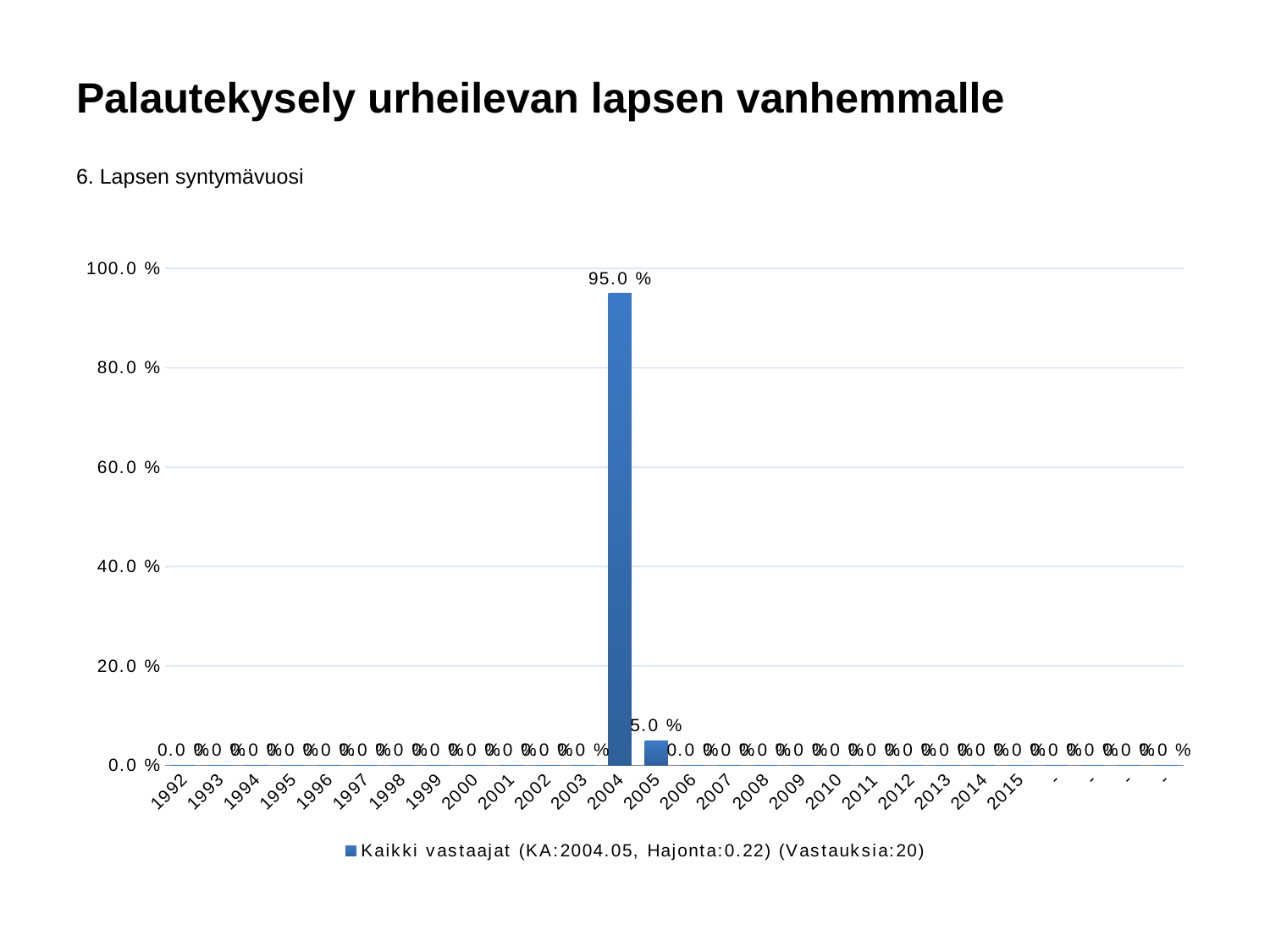
How many birth years have a value above 0.0 %? 2 What is the value for 2003? 0.0 % What is the legend entry of the chart? Kaikki vastaajat (KA:2004.05, Hajonta:0.22) (Vastauksia:20) Which birth year has the highest value? 2004 What is the difference between the values for 2004 and 2005? 90.0 % How many series does the legend list? 1 What is the value for 2004? 95.0 % What is the value for 2005? 5.0 % Is the value for 2004 greater or less than 80.0 %? greater Is the value for 2005 greater or less than 20.0 %? less What kind of chart is shown on the slide? bar chart Which has the larger value, 2004 or 2005? 2004